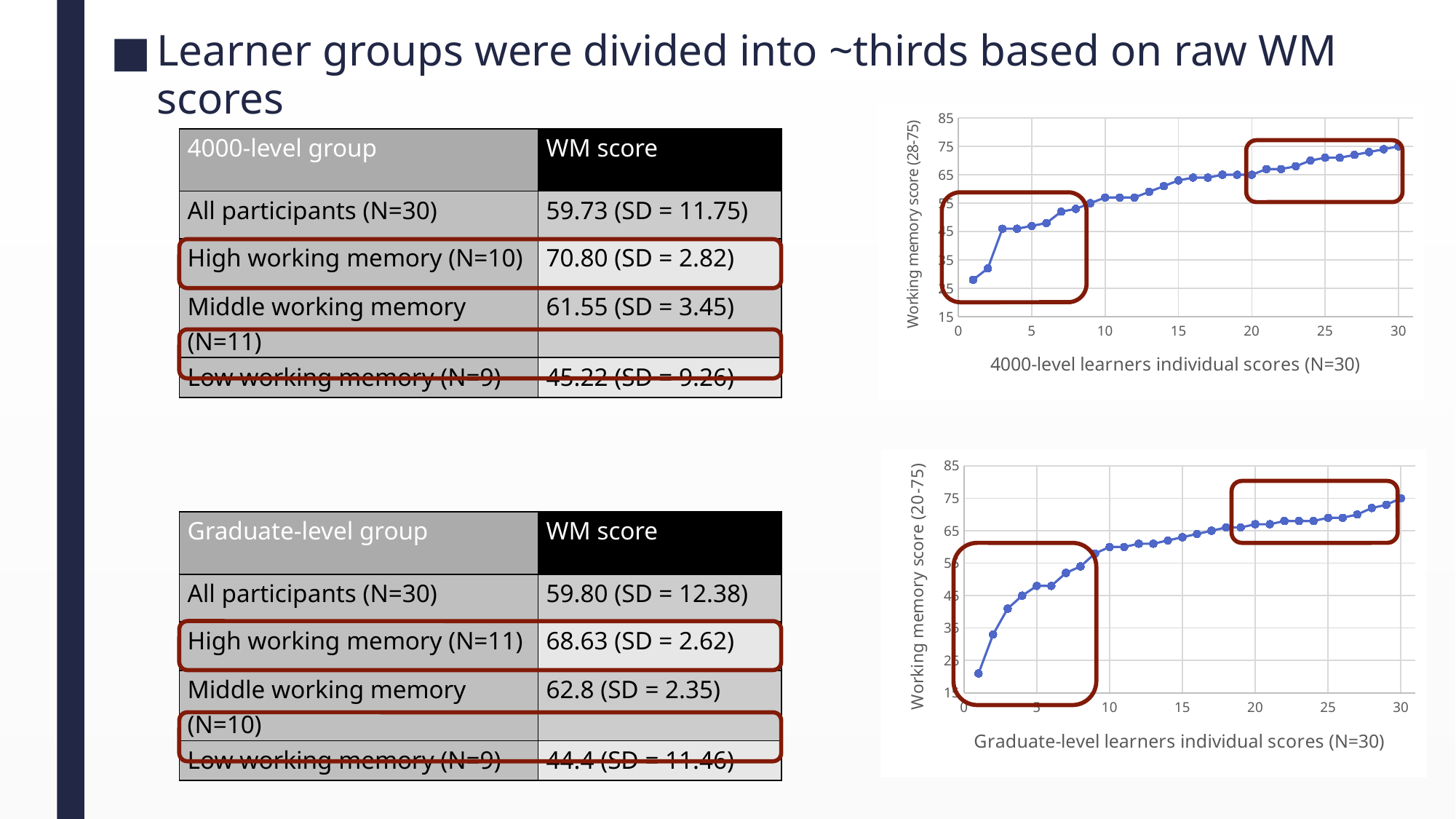
In the 'Graduate-level learners individual scores (N=30)' chart, do the values rise or fall along the x axis? rise What is the y-axis label of the '4000-level learners individual scores (N=30)' chart? Working memory score (28-75) In the 'Graduate-level learners individual scores (N=30)' chart, which is larger: the value of the first point or the value of the last point? the last point In the '4000-level learners individual scores (N=30)' chart, do the values rise or fall along the x axis? rise In the '4000-level learners individual scores (N=30)' chart, is the value of the first point (x=1) greater or less than 35? less How many data points are plotted in the 'Graduate-level learners individual scores (N=30)' chart? 30 What is the y-axis label of the 'Graduate-level learners individual scores (N=30)' chart? Working memory score (20-75) In the 'Graduate-level learners individual scores (N=30)' chart, is the value at x=20 greater or less than 55? greater In the 'Graduate-level learners individual scores (N=30)' chart, is the value of the first point (x=1) greater or less than 25? less What kind of chart is the '4000-level learners individual scores (N=30)' chart? line chart How many data points are plotted in the '4000-level learners individual scores (N=30)' chart? 30